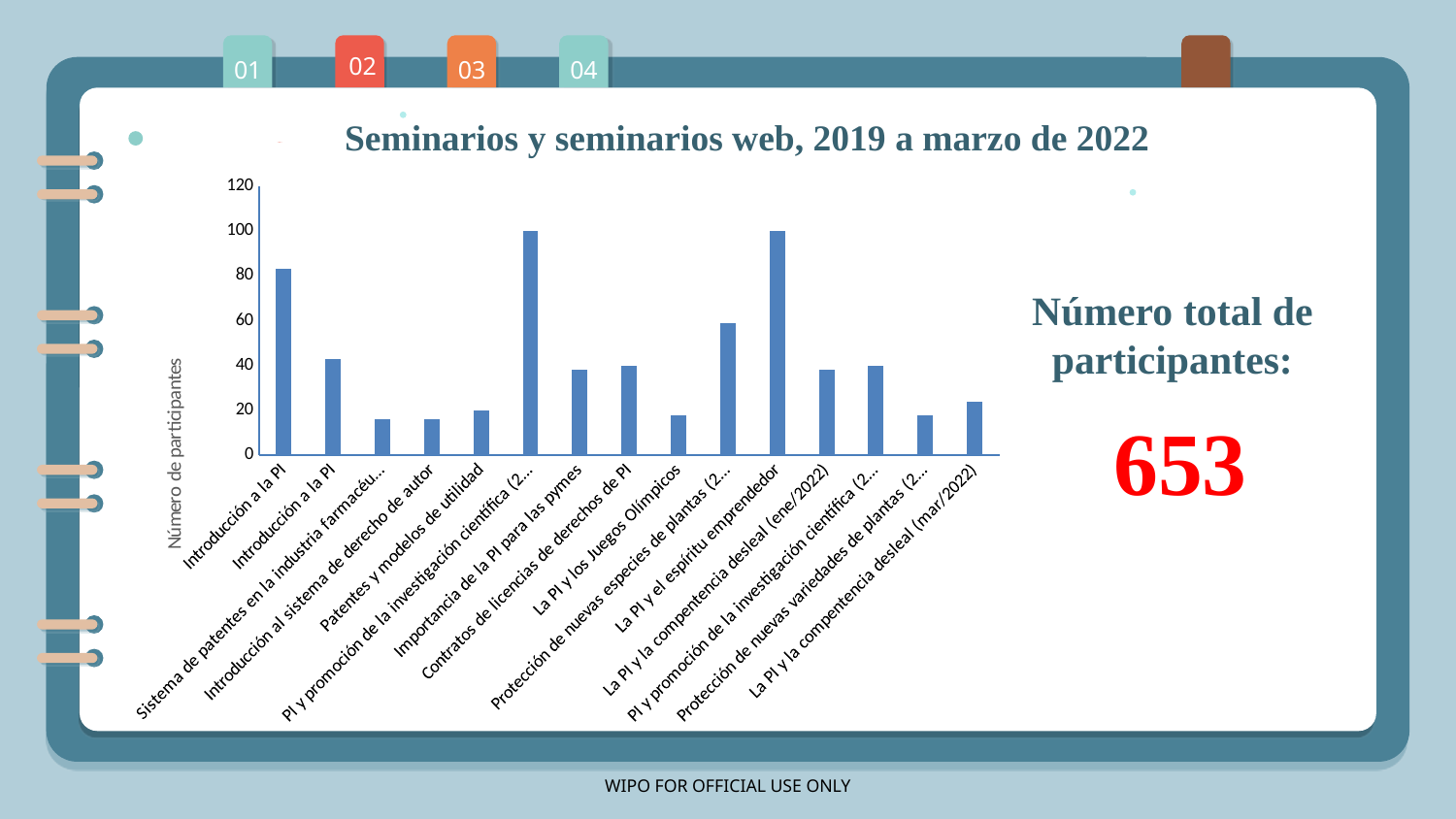
Is the value for 'Patentes y modelos de utilidad' greater or less than 40? less What kind of chart is shown on the slide? bar chart Is the value for 'Protección de nuevas especies de plantas (2...' greater or less than 40? greater What is the label on the vertical axis of the chart? Número de participantes Is the value for the first 'Introducción a la PI' bar greater or less than 60? greater How many bars (seminars) are plotted in the chart? 15 Which has more participants: 'Protección de nuevas especies de plantas (2...' or 'La PI y la competencia desleal (mar/2022)'? Protección de nuevas especies de plantas (2... What is the title of the chart? Seminarios y seminarios web, 2019 a marzo de 2022 Which has more participants: 'Introducción al sistema de derecho de autor' or 'Contratos de licencias de derechos de PI'? Contratos de licencias de derechos de PI